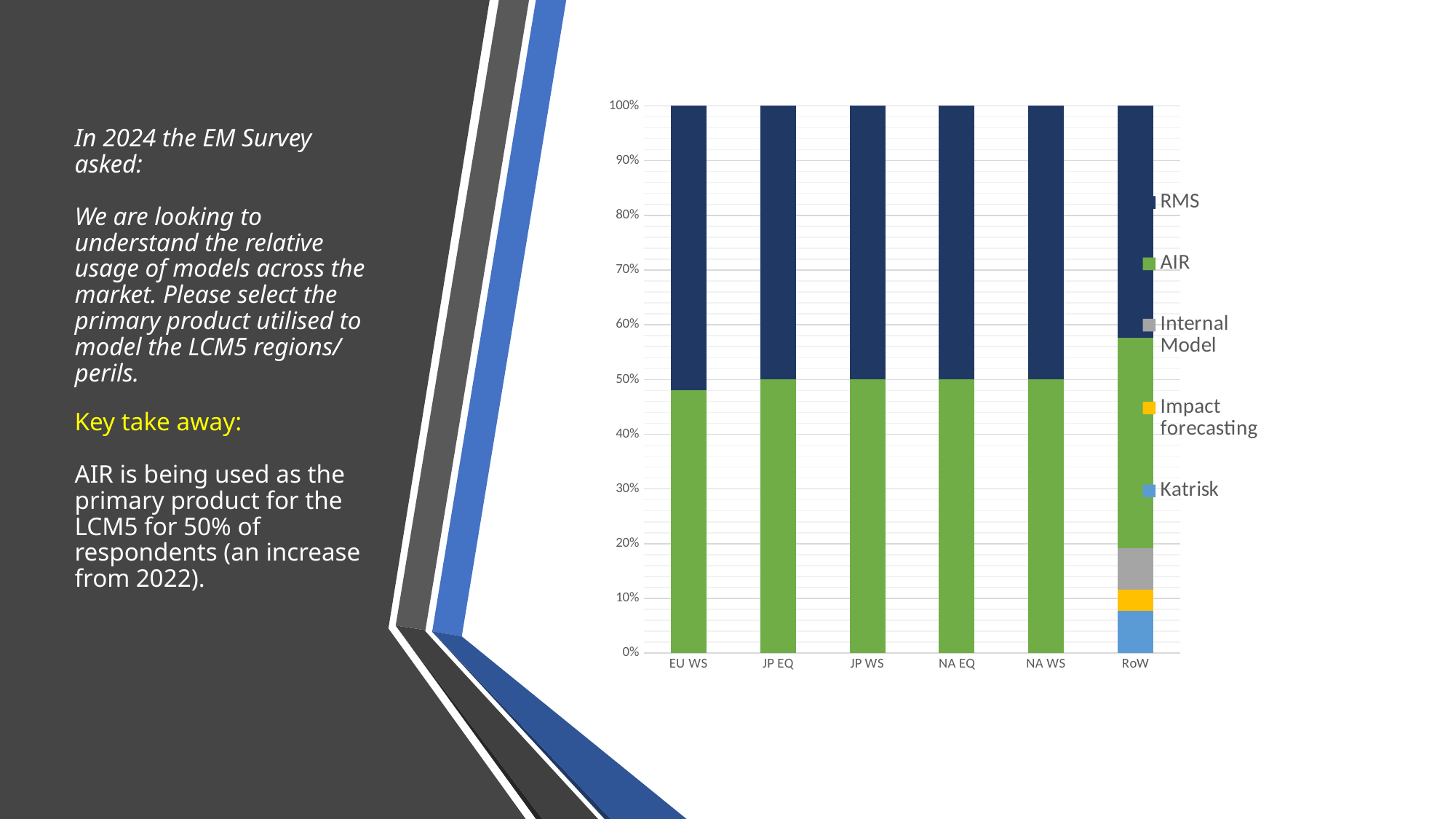
Which category has the smallest AIR share? RoW How many series does the chart's legend list? 5 Is the Katrisk share for RoW greater or less than 10%? less How many categories are shown along the x axis of the chart? 6 What kind of chart is shown on the slide? Stacked bar chart What share does AIR have for JP EQ? 50% What share does RMS have for NA WS? 50% Which has the larger AIR share, NA WS or RoW? NA WS Is the AIR share for RoW greater or less than 30%? greater Which category is the only one with Katrisk, Impact forecasting and Internal Model segments? RoW Is the AIR share for EU WS greater or less than 50%? less